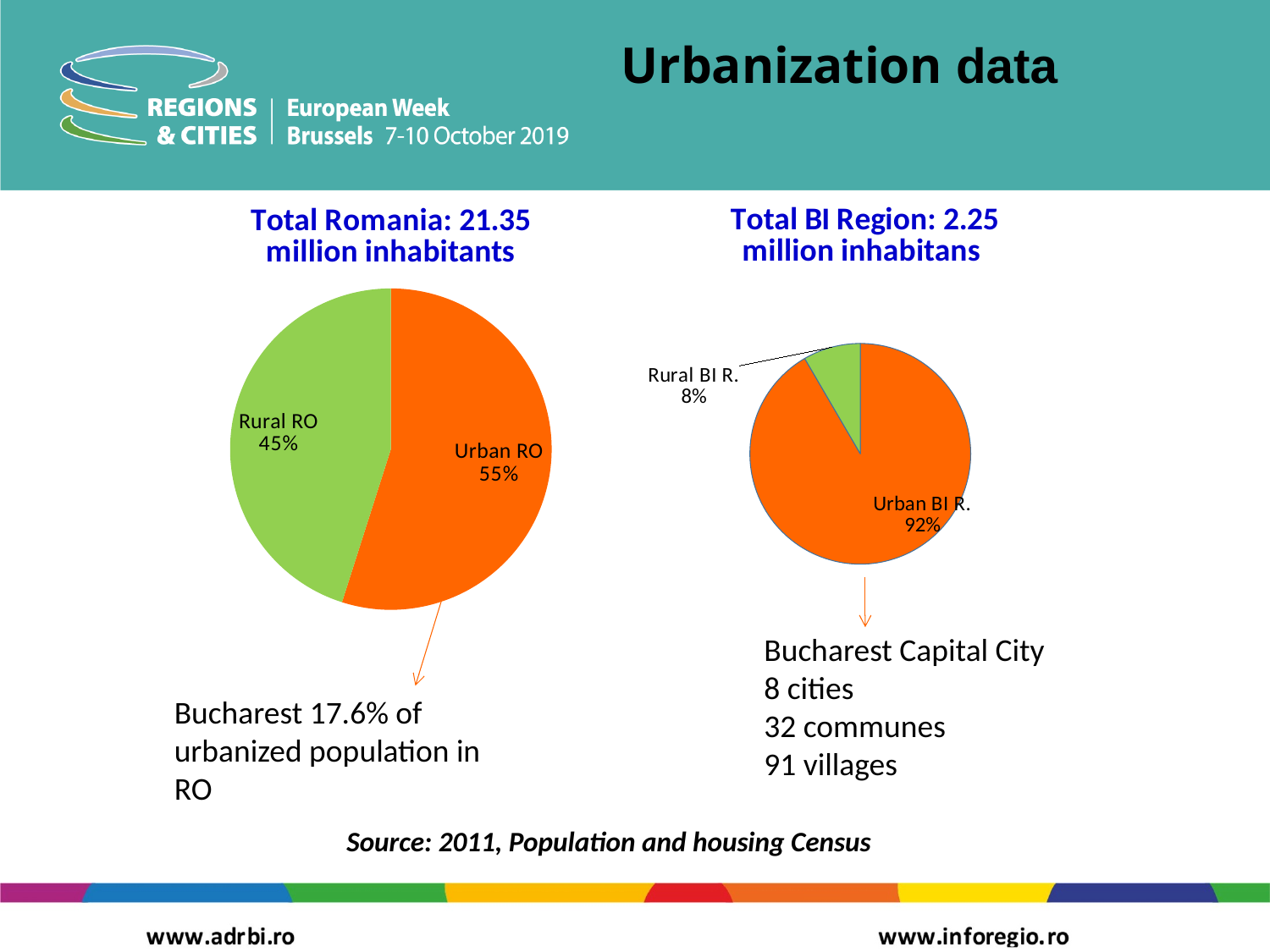
In the 'Total Romania: 21.35 million inhabitants' chart, what share is Rural RO? 45% In the 'Total BI Region: 2.25 million inhabitans' chart, what is the difference between the Urban BI R. and Rural BI R. shares? 84% In the 'Total Romania: 21.35 million inhabitants' chart, what is the difference between the Urban RO and Rural RO shares? 10% What type of chart is the 'Total BI Region: 2.25 million inhabitans' chart? Pie chart In the 'Total Romania: 21.35 million inhabitants' chart, what share is Urban RO? 55% In the 'Total Romania: 21.35 million inhabitants' chart, what colour is the Rural RO slice? Green In the 'Total BI Region: 2.25 million inhabitans' chart, which slice is the smallest? Rural BI R. In the 'Total BI Region: 2.25 million inhabitans' chart, what share is Urban BI R.? 92% In the 'Total BI Region: 2.25 million inhabitans' chart, what share is Rural BI R.? 8% In the 'Total Romania: 21.35 million inhabitants' chart, which slice is the largest? Urban RO Which is larger: the Rural RO share in the left chart or the Rural BI R. share in the right chart? Rural RO How many slices does the 'Total Romania: 21.35 million inhabitants' chart have? 2